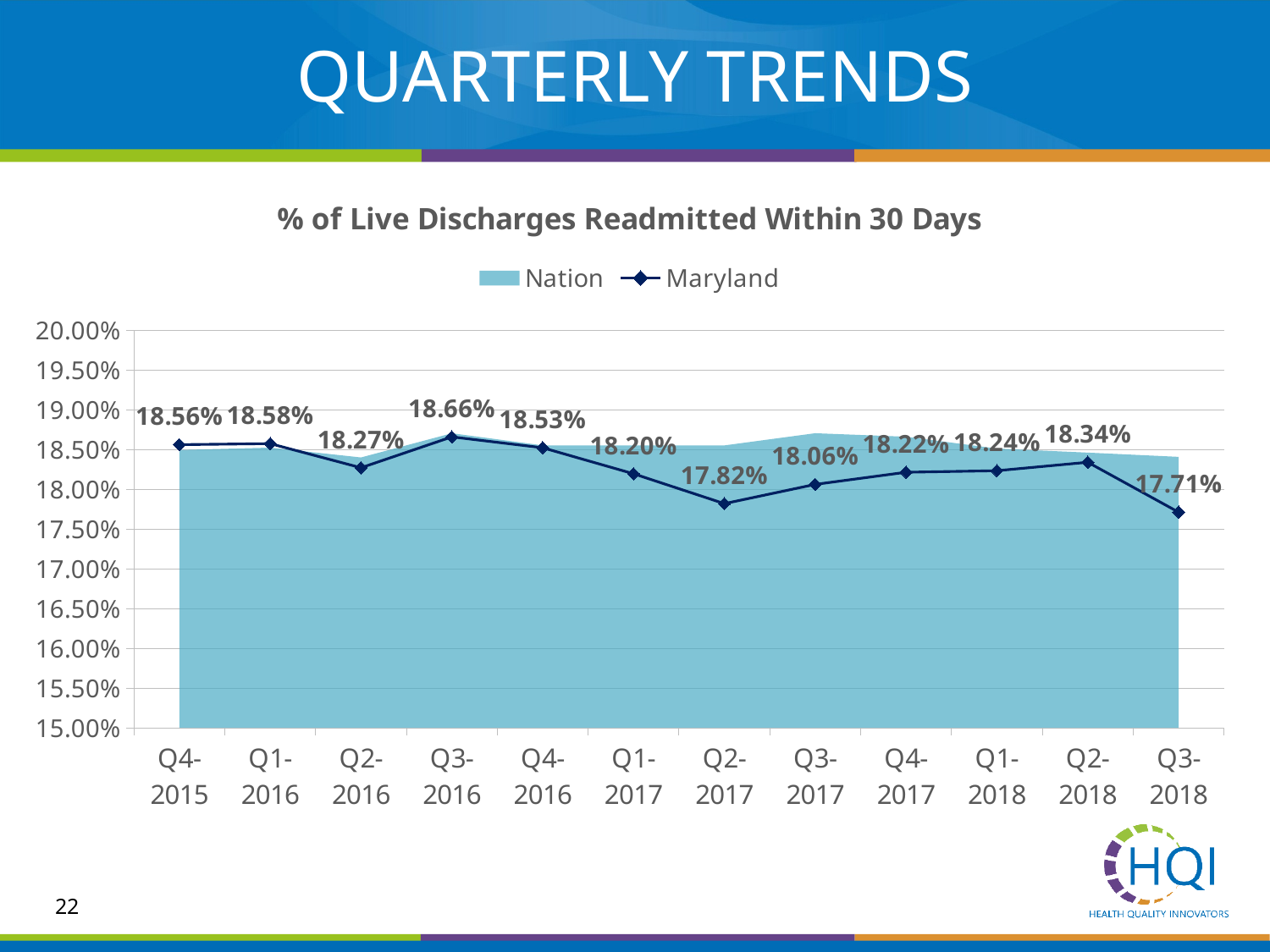
What is the Maryland value for Q3-2016? 18.66% In which quarter is the Maryland value highest? Q3-2016 What is the Maryland value for Q3-2018? 17.71% What is the difference between the highest and lowest Maryland values? 0.95 percentage points In which quarter is the Maryland value lowest? Q3-2018 What is the Maryland value for Q2-2017? 17.82% Does the Maryland value rise or fall from Q2-2018 to Q3-2018? fall Which is larger for Maryland: Q2-2017 or Q3-2017? Q3-2017 What kind of chart is used to plot the Maryland series? line chart How many quarters are shown on the x axis? 12 Is the Nation value for Q3-2018 greater or less than 18.00%? greater How many series does the legend list? 2